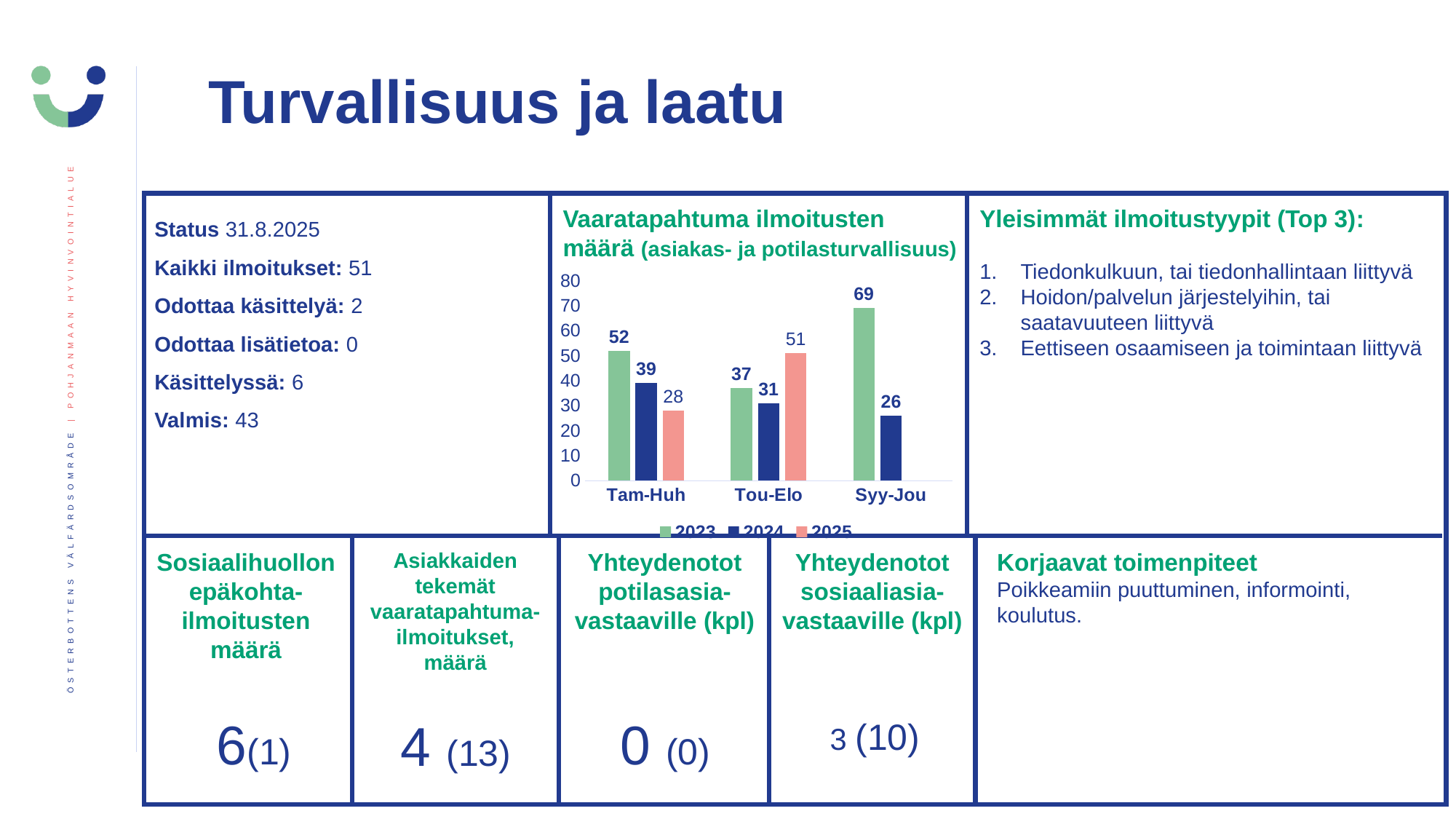
What is the value for 2023 in the Tam-Huh category? 52 Which category has the highest value for the 2023 series? Syy-Jou What is the value for 2024 in the Syy-Jou category? 26 What is the value for 2025 in the Tam-Huh category? 28 How many categories are shown on the x axis of the chart? 3 What is the difference between the 2023 and 2024 values in the Tam-Huh category? 13 What type of chart is shown on the slide? bar chart Which is larger in the Tou-Elo category: the 2023 value or the 2025 value? 2025 How many series does the chart legend list? 3 Does the 2024 value rise or fall across the categories from Tam-Huh to Syy-Jou? fall Which category has the lowest value for the 2024 series? Syy-Jou What is the value for 2025 in the Tou-Elo category? 51